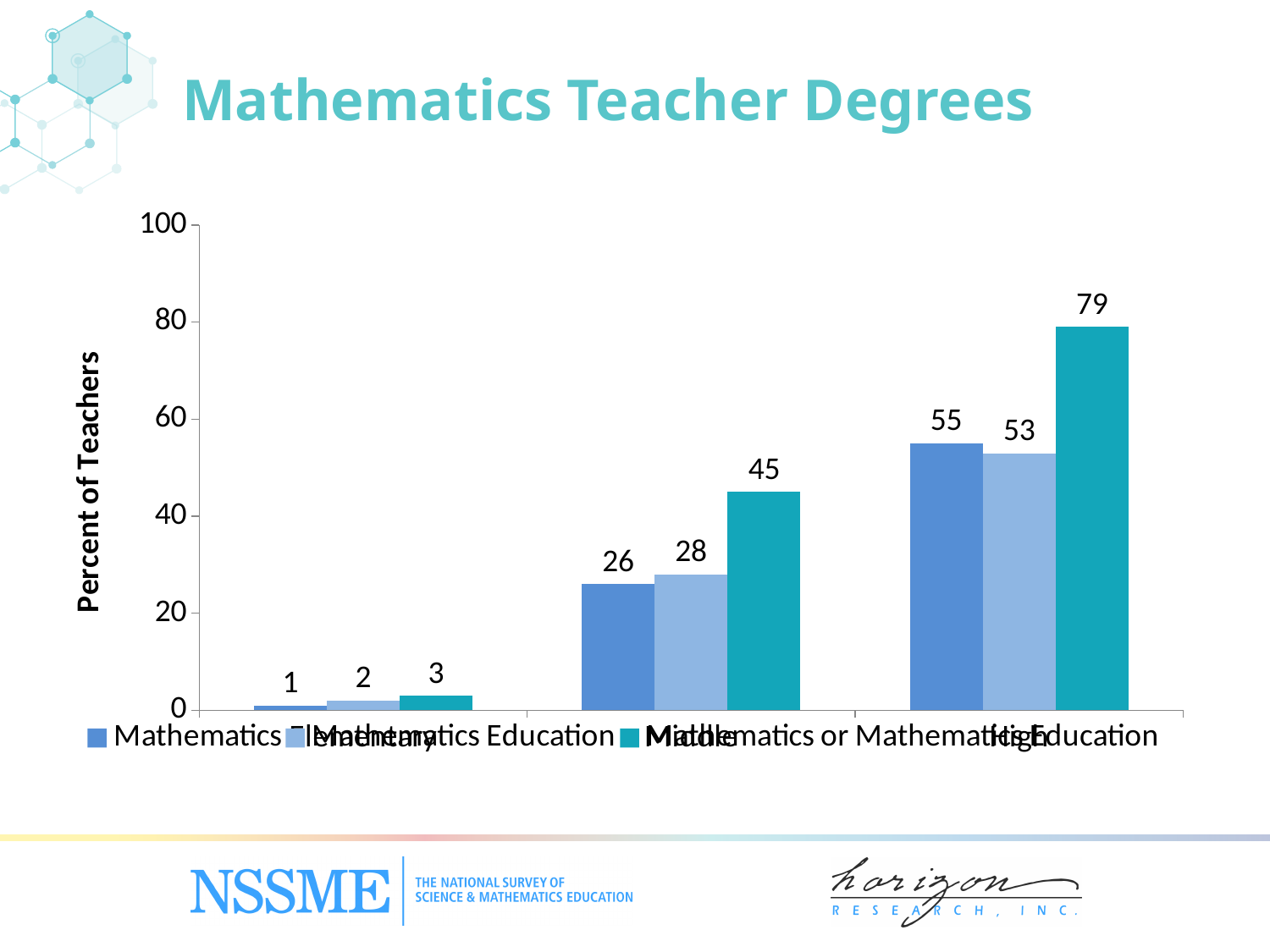
What is the value for Mathematics among elementary teachers? 1 How many series does the legend list? 3 Which grade level has the lowest value for Mathematics? Elementary What is the value for Mathematics Education among middle school teachers? 28 How many grade-level categories are shown on the x axis? 3 For high school teachers, which is larger: the Mathematics value or the Mathematics Education value? Mathematics What percent of high school mathematics teachers have a degree in Mathematics or Mathematics Education? 79 What kind of chart is shown on the slide? Bar chart Is the Mathematics or Mathematics Education value for Middle greater or less than 40? greater Which grade level has the highest value for Mathematics or Mathematics Education? High What is the label of the y axis? Percent of Teachers What is the difference between the Mathematics or Mathematics Education values for High and Middle? 34